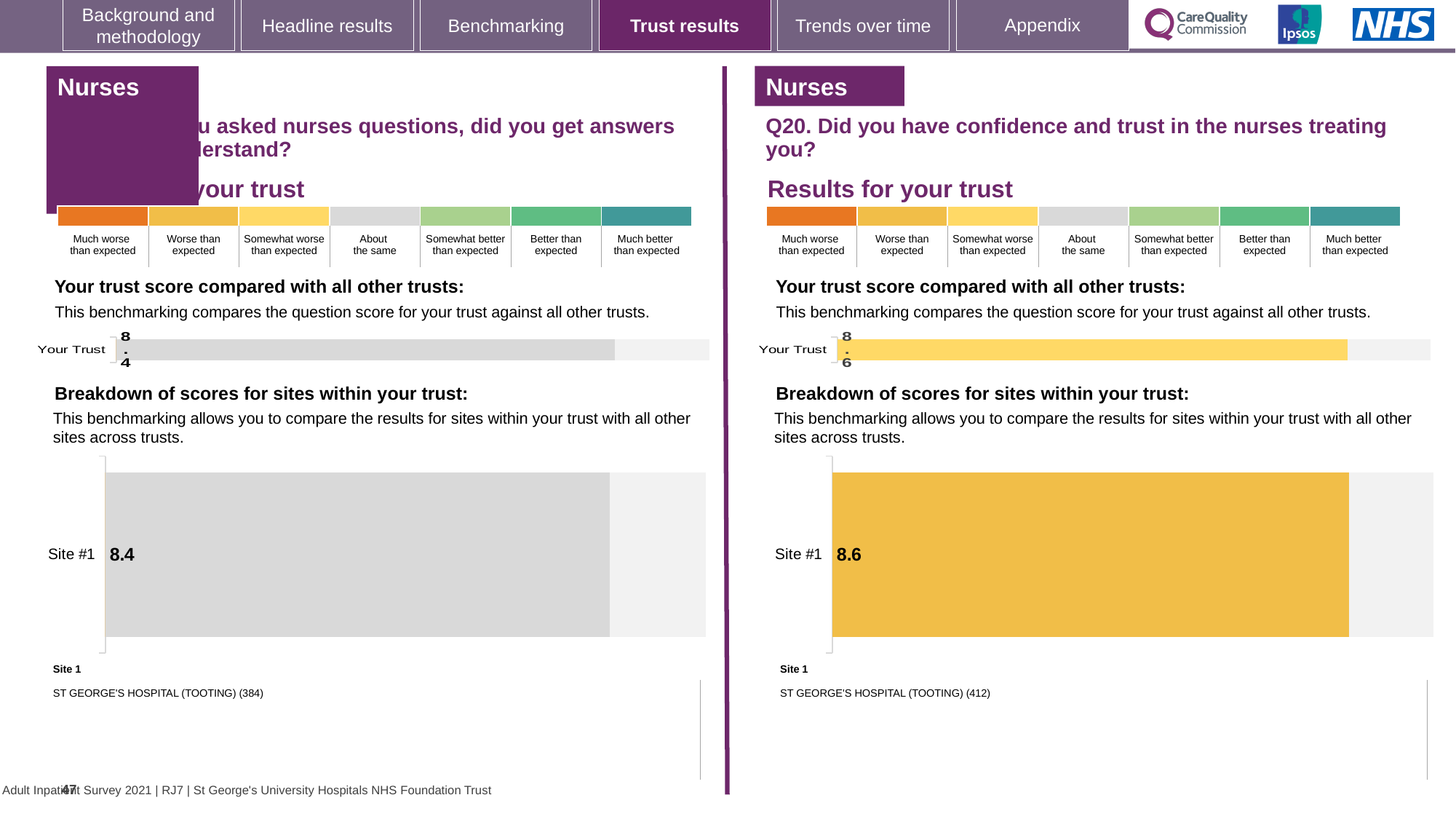
On the left-hand 'Breakdown of scores for sites within your trust' chart, what is the score for Site #1? 8.4 Which site name is listed as Site 1 under the right-hand Q20 breakdown chart? ST GEORGE'S HOSPITAL (TOOTING) (412) What kind of chart is used for the 'Your Trust' score on the right-hand side of the slide? Bar chart On the right-hand 'Your trust score compared with all other trusts' chart (Q20), what is the value for Your Trust? 8.6 On the left-hand 'Your trust score compared with all other trusts' chart, what is the value for Your Trust? 8.4 Which is larger: the Your Trust score on the left-hand chart or the Your Trust score on the right-hand Q20 chart? The right-hand Q20 chart What is the difference between the Site #1 score on the right-hand Q20 chart and the Site #1 score on the left-hand chart? 0.2 How many sites are shown in the left-hand 'Breakdown of scores for sites within your trust' chart? 1 What kind of chart is used for the Site #1 breakdown on the left-hand side of the slide? Bar chart On the right-hand 'Breakdown of scores for sites within your trust' chart (Q20), what is the score for Site #1? 8.6 How many sites are shown in the right-hand 'Breakdown of scores for sites within your trust' chart? 1